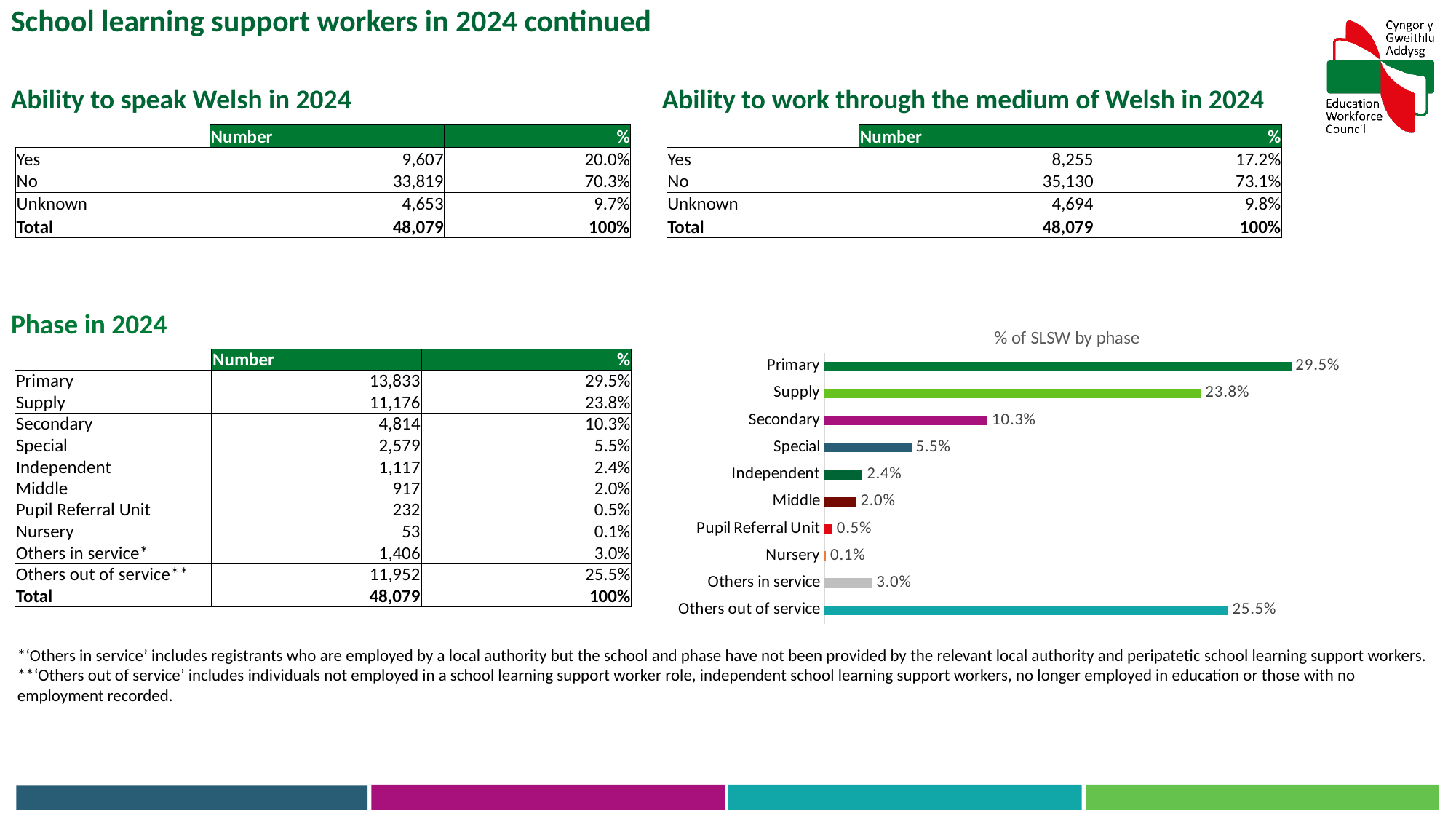
How many phases are shown in the '% of SLSW by phase' chart? 10 What is the title of the bar chart on the slide? % of SLSW by phase In the '% of SLSW by phase' chart, what is the value for Supply? 23.8% In the '% of SLSW by phase' chart, which phase has the highest value? Primary In the '% of SLSW by phase' chart, which is larger, Supply or Others out of service? Others out of service In the '% of SLSW by phase' chart, which phase has the lowest value? Nursery In the '% of SLSW by phase' chart, what is the difference between Primary and Supply? 5.7% In the '% of SLSW by phase' chart, what is the difference between Secondary and Special? 4.8% In the '% of SLSW by phase' chart, what is the value for Pupil Referral Unit? 0.5% What kind of chart is '% of SLSW by phase'? bar chart In the '% of SLSW by phase' chart, what is the value for Others out of service? 25.5% In the '% of SLSW by phase' chart, what is the value for Primary? 29.5%